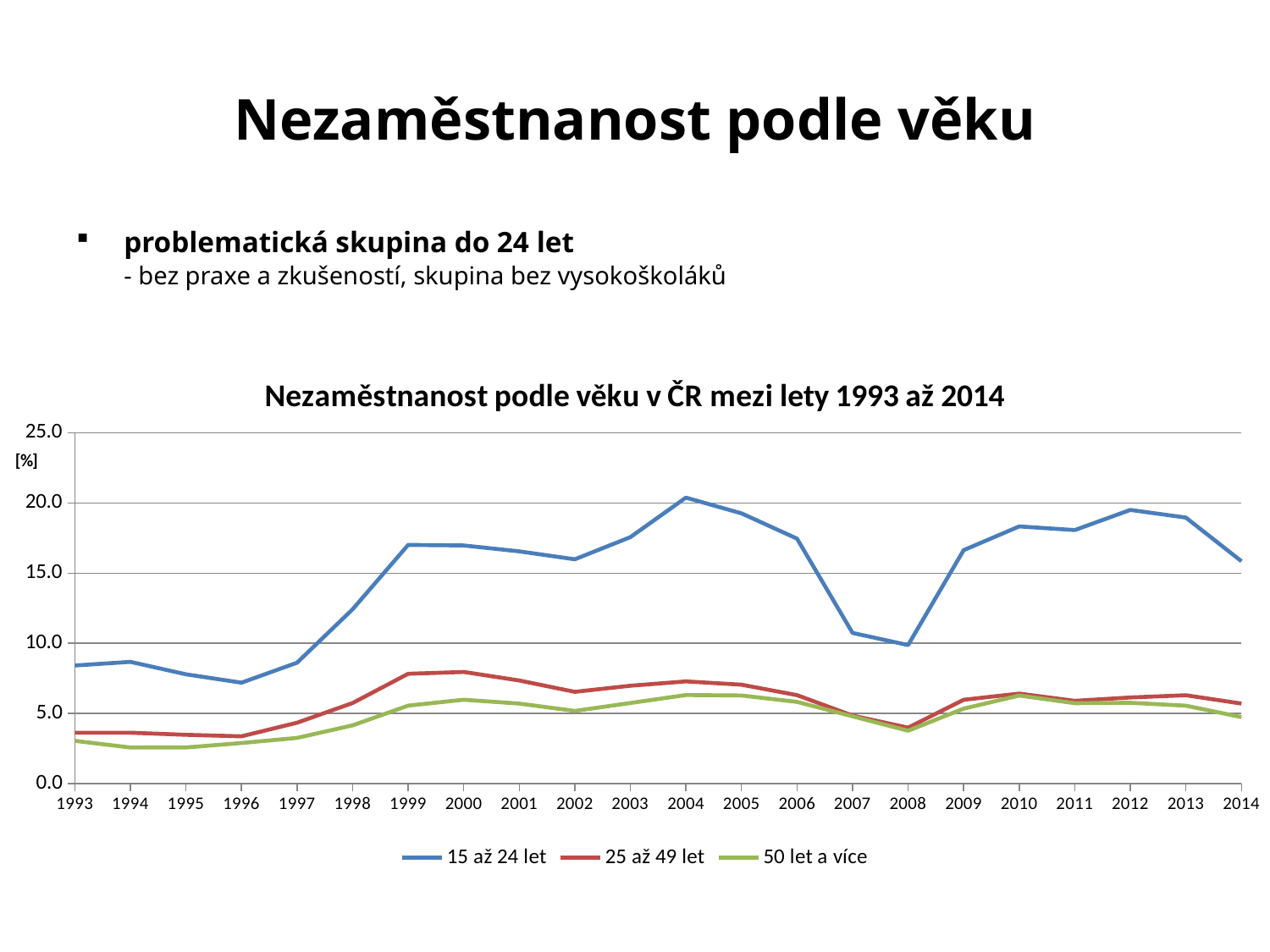
In 2014, which series has the higher value: '25 až 49 let' or '50 let a více'? 25 až 49 let Is the value for '15 až 24 let' in 2007 greater or less than 15.0? less In which year does the series '15 až 24 let' reach its lowest value? 1996 What is the title of the chart? Nezaměstnanost podle věku v ČR mezi lety 1993 až 2014 In which year does the series '15 až 24 let' reach its highest value? 2004 Is the value for '50 let a více' in 2008 greater or less than 5.0? less How many years are plotted along the x axis of the chart? 22 Does the series '15 až 24 let' rise or fall between 2004 and 2008? fall What kind of chart is shown on the slide? line chart What colour is the line for the series '50 let a více'? green How many series does the legend of the chart list? 3 Is the value for '15 až 24 let' in 1999 greater or less than 15.0? greater